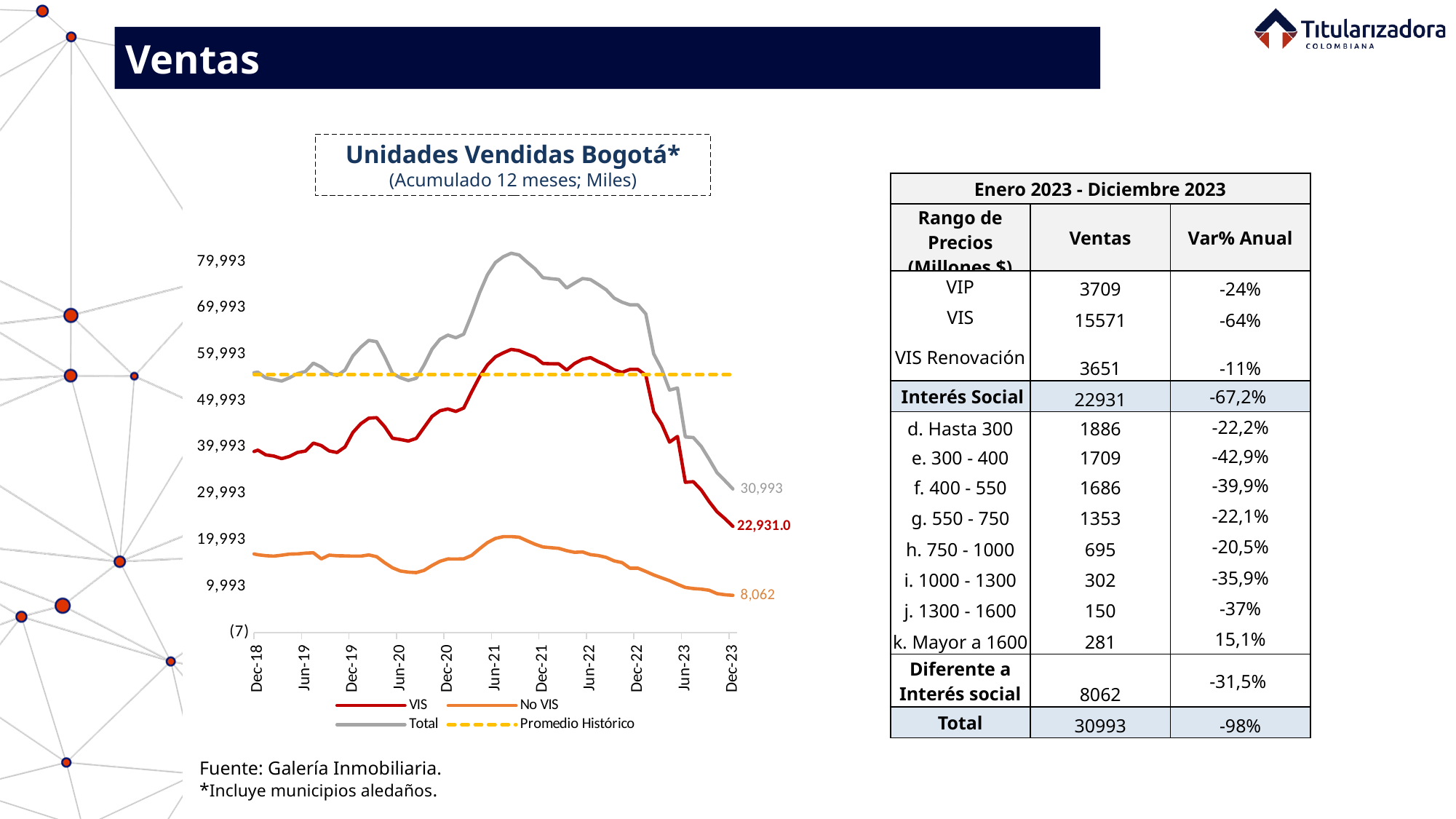
How many series does the legend of the chart list? 4 What is the difference between the Total and VIS values at Dec-23? 8,062 What is the value of the No VIS series at Dec-23? 8,062 Which series is drawn as a dashed yellow line? Promedio Histórico What kind of chart is "Unidades Vendidas Bogotá*"? line chart What is the value of the VIS series at Dec-23? 22,931.0 Which series has the highest value at Dec-23? Promedio Histórico Is the value of the VIS series at Dec-18 greater or less than 49,993? less What is the value of the Total series at Dec-23? 30,993 Does the Total series rise or fall between Dec-22 and Dec-23? fall Is the value of the No VIS series at Jun-21 greater or less than 9,993? greater At Dec-23, which is larger: VIS or No VIS? VIS